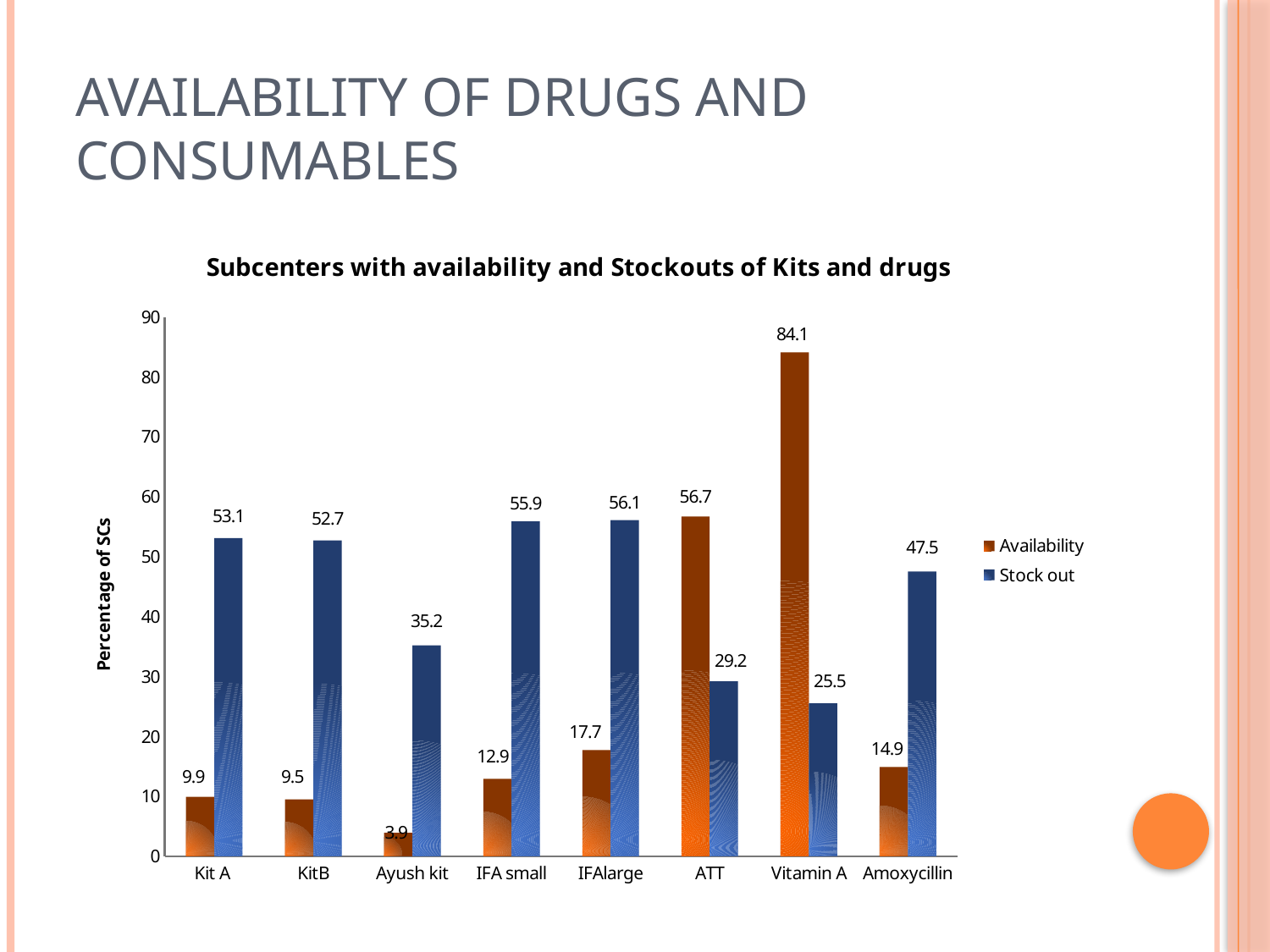
What is the difference between the Stock out and Availability values for Kit A? 43.2 What is the label on the vertical axis? Percentage of SCs How many series does the legend list? 2 What is the Availability value for Amoxycillin? 14.9 Which category has the highest Stock out value? IFAlarge Is the Stock out value for Amoxycillin greater or less than 40? greater How many categories are shown on the x axis? 8 Which is larger for ATT, the Availability value or the Stock out value? Availability What kind of chart is shown on the slide? Bar chart What is the Availability value for Vitamin A? 84.1 What is the Stock out value for IFA small? 55.9 Which category has the lowest Availability value? Ayush kit